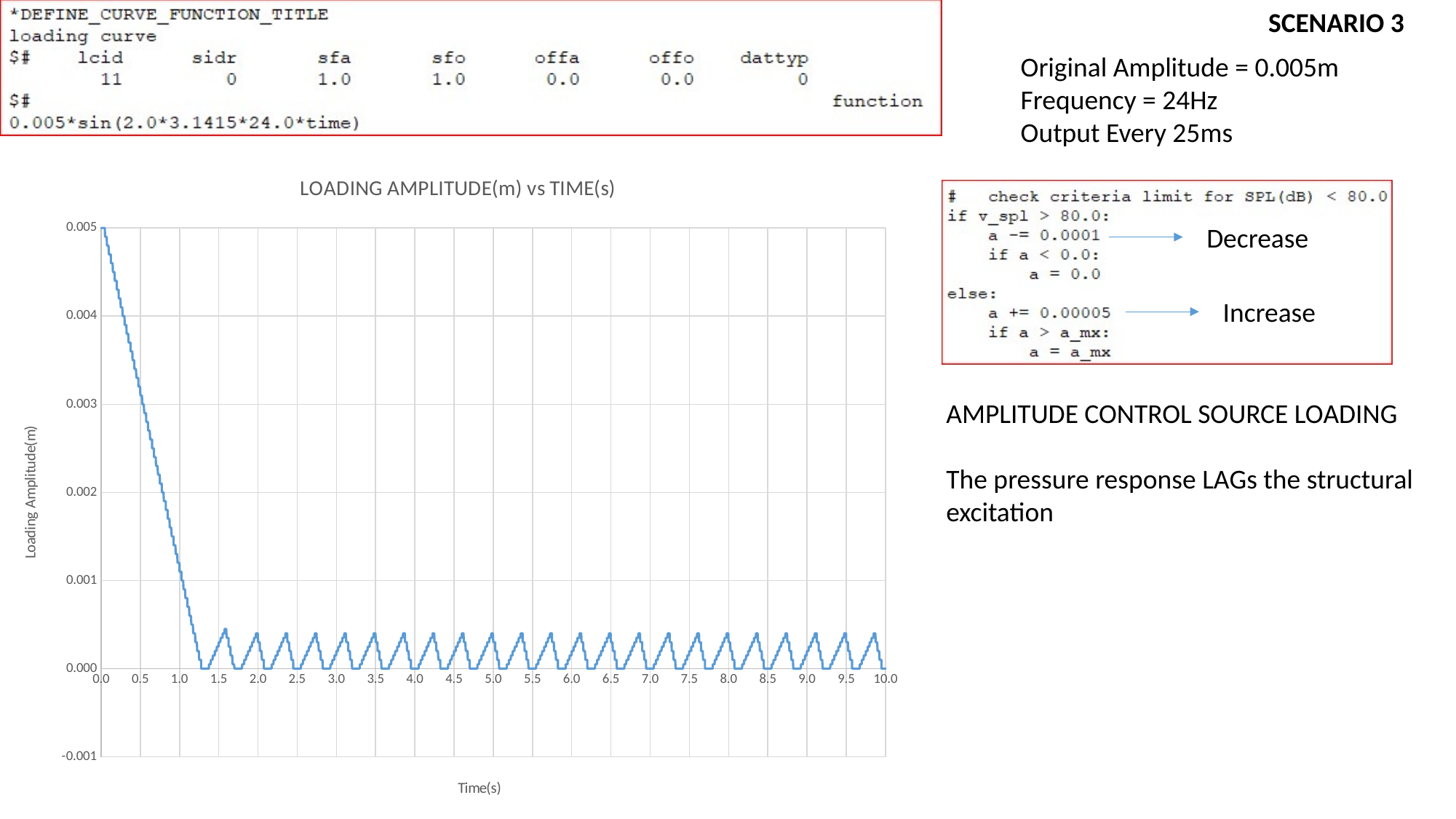
What kind of chart is shown on the slide? line chart At what time does the loading amplitude reach its highest value? 0.0 Is the loading amplitude at time 5.0 s greater or less than 0.001? less What is the loading amplitude at time 0.0 s? 0.005 Is the loading amplitude at time 1.0 s greater or less than 0.002? less What is the title of the chart? LOADING AMPLITUDE(m) vs TIME(s) Is the loading amplitude at time 0.5 s greater or less than 0.002? greater Does the loading amplitude rise or fall between time 0.0 s and 1.0 s? fall What is the highest value shown on the vertical axis of the chart? 0.005 What is the largest time value shown on the horizontal axis? 10.0 Which is larger, the loading amplitude at time 0.5 s or at time 8.0 s? 0.5 s What is the label of the vertical axis of the chart? Loading Amplitude(m)